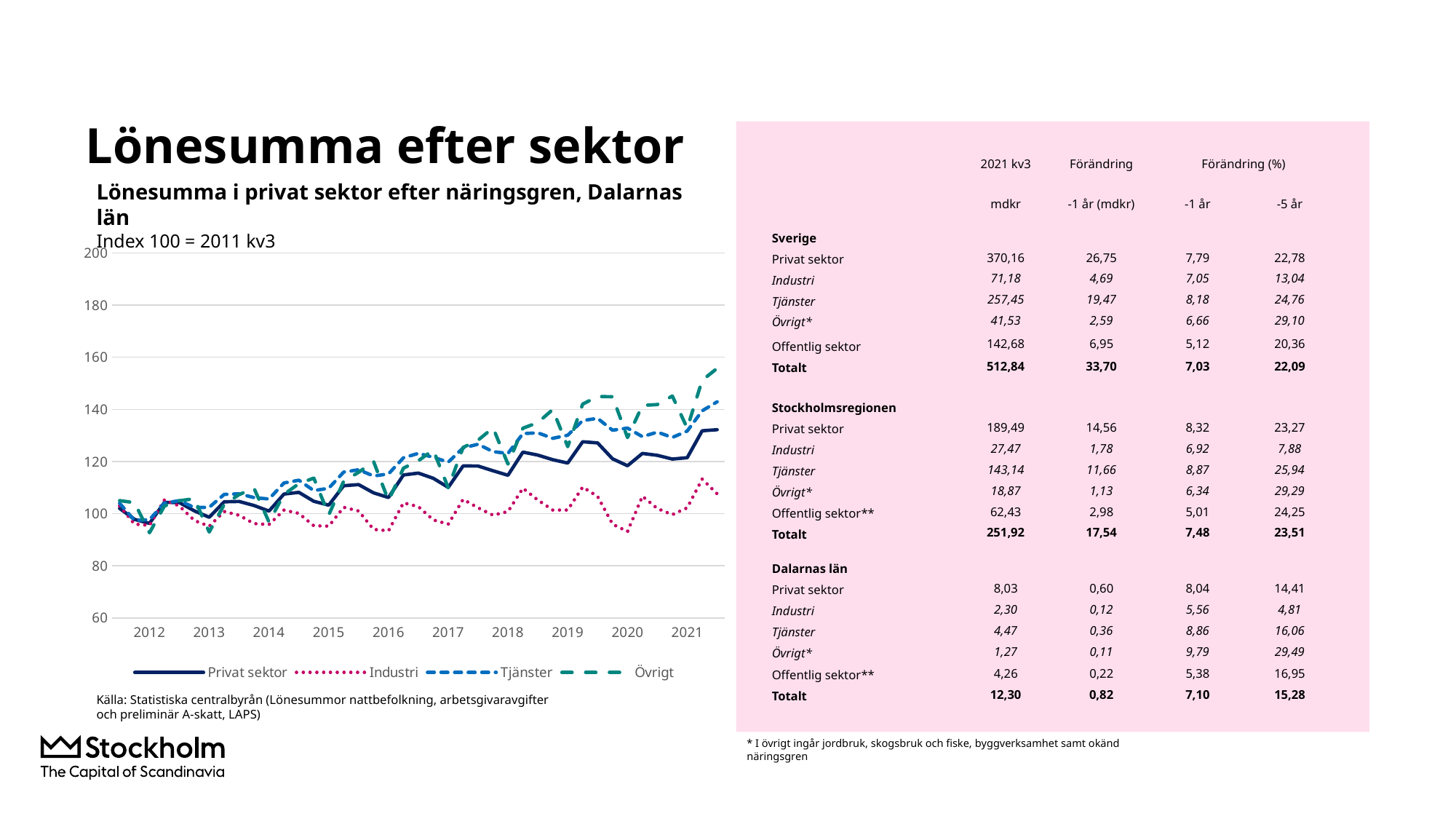
What kind of chart is shown on the slide? line chart How many series does the chart legend list? 4 How many year labels are shown on the x axis of the chart? 10 Is the value for Övrigt at the end of 2021 greater or less than 140? greater Does the Privat sektor series rise or fall overall from 2012 to 2021? rise What is the base period of the index used in the chart? Index 100 = 2011 kv3 Is the value for Privat sektor at the end of 2021 greater or less than 120? greater Is the value for Industri at the end of 2021 greater or less than 120? less Which series has the lowest value at the end of the chart in 2021? Industri At the end of 2021, which is larger: Övrigt or Industri? Övrigt Which series are listed in the chart legend? Privat sektor, Industri, Tjänster, Övrigt Which series has the highest value at the end of the chart in 2021? Övrigt